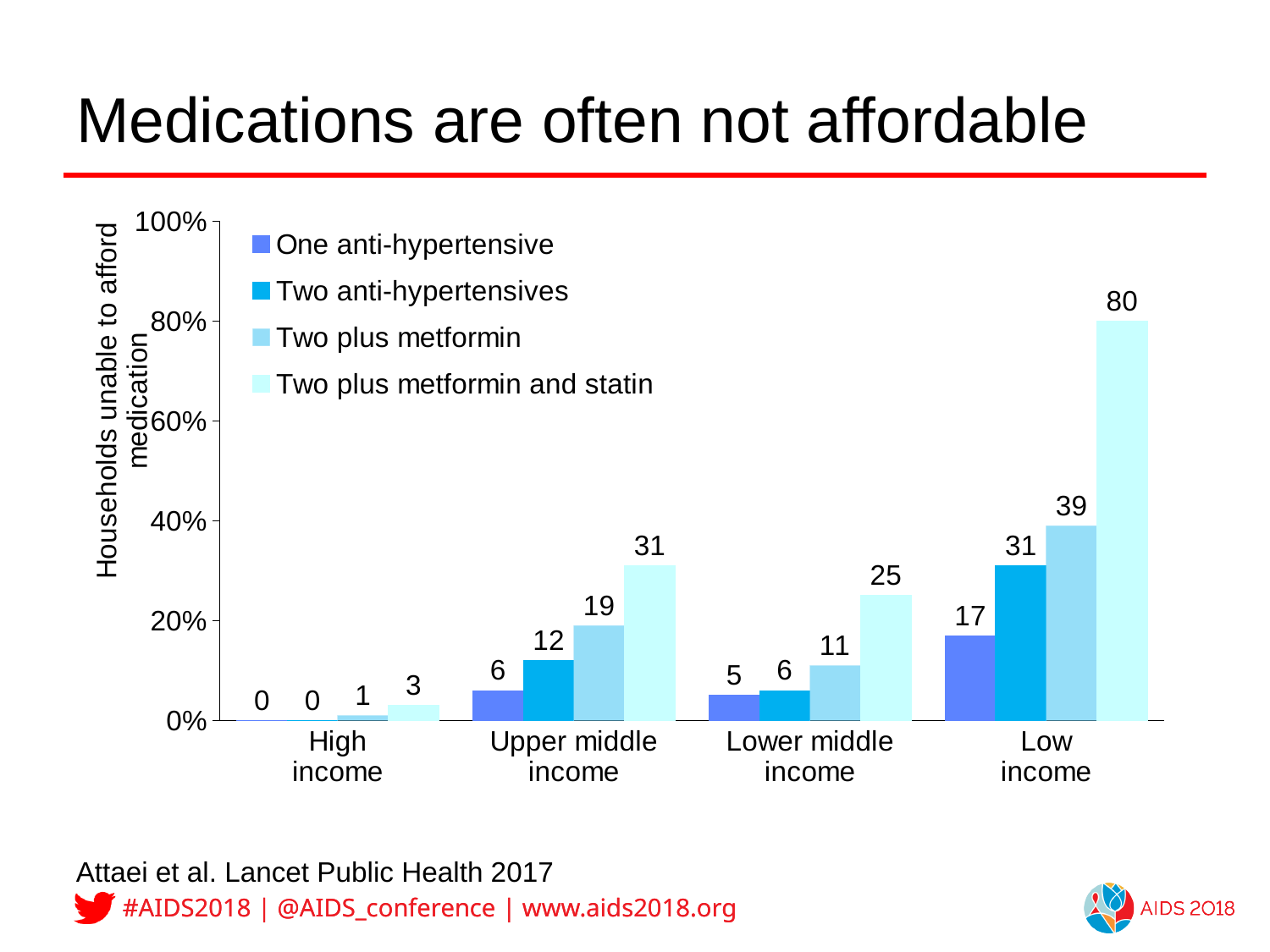
What is the difference between the Two plus metformin and statin values for Low income and Upper middle income? 49 Which income group has the lowest value for Two plus metformin and statin? High income What is the value for Two plus metformin and statin in the Low income group? 80 What is the label of the y axis? Households unable to afford medication How many series does the legend list? 4 What is the value for Two anti-hypertensives in the Upper middle income group? 12 Is the value for Two plus metformin and statin in the Low income group greater or less than 60%? greater How many income groups are shown on the x axis? 4 What kind of chart is shown on the slide? bar chart Which income group has the highest value for Two plus metformin? Low income Which is larger: Two plus metformin in Upper middle income or Two plus metformin in Lower middle income? Upper middle income What is the value for One anti-hypertensive in the Lower middle income group? 5